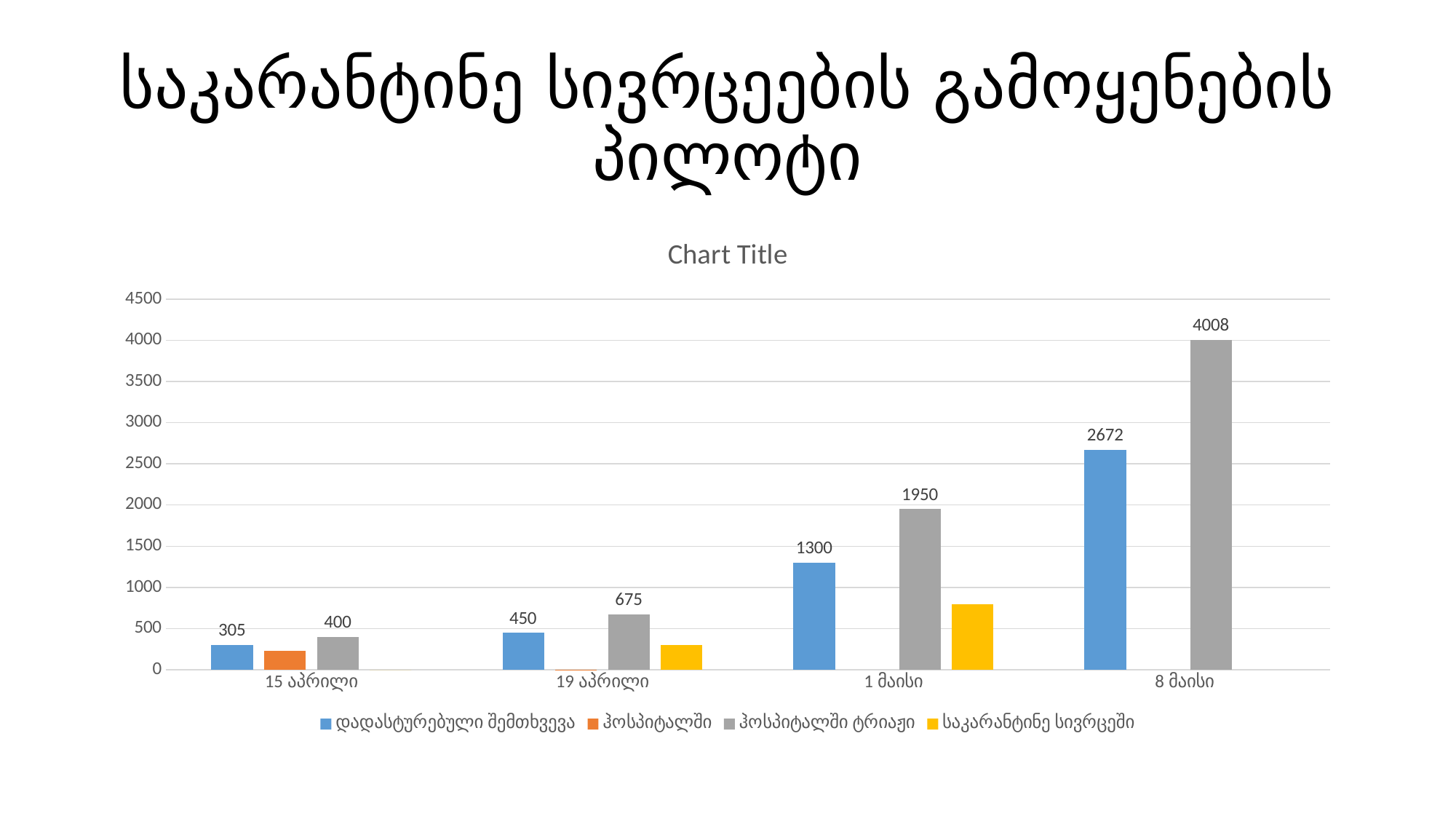
What type of chart is shown on the slide? bar chart What is the value of დადასტურებული შემთხვევა for 15 აპრილი? 305 What is the value of ჰოსპიტალში ტრიაჟი for 8 მაისი? 4008 Does the value of დადასტურებული შემთხვევა rise or fall from 15 აპრილი to 8 მაისი? rise Is the value of საკარანტინე სივრცეში for 1 მაისი greater or less than 1000? less What is the value of ჰოსპიტალში ტრიაჟი for 19 აპრილი? 675 How many categories are shown on the x axis? 4 Which category has the lowest value for დადასტურებული შემთხვევა? 15 აპრილი How many series does the legend list? 4 What is the value of დადასტურებული შემთხვევა for 1 მაისი? 1300 Which category has the highest value for ჰოსპიტალში ტრიაჟი? 8 მაისი What is the difference between ჰოსპიტალში ტრიაჟი and დადასტურებული შემთხვევა for 8 მაისი? 1336